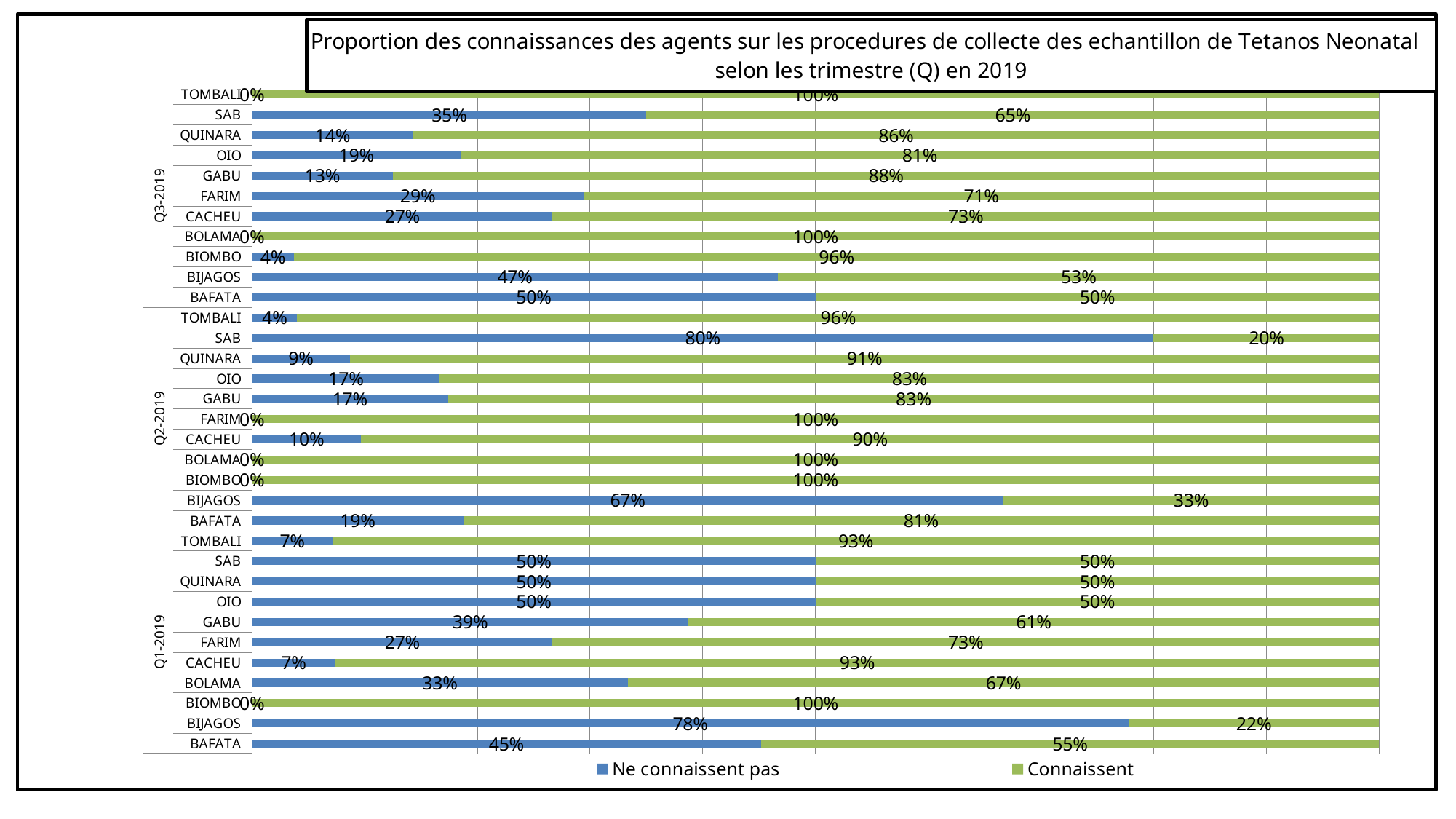
How many regions are listed for each quarter? 11 Which colour represents the 'Connaissent' series? Green What is the 'Connaissent' value for SAB in Q3-2019? 65% In Q2-2019, which region has the highest 'Ne connaissent pas' value? SAB In Q3-2019, which region has the lowest 'Connaissent' value? BAFATA What kind of chart is shown on the slide? Bar chart How many series does the legend list? 2 For SAB in Q3-2019, what is the difference between the 'Connaissent' and 'Ne connaissent pas' values? 30 percentage points What is the 'Ne connaissent pas' value for BIJAGOS in Q1-2019? 78% What is the 'Connaissent' value for GABU in Q1-2019? 61% Is the 'Ne connaissent pas' value for BIJAGOS larger in Q2-2019 or in Q3-2019? Q2-2019 What is the 'Ne connaissent pas' value for SAB in Q2-2019? 80%